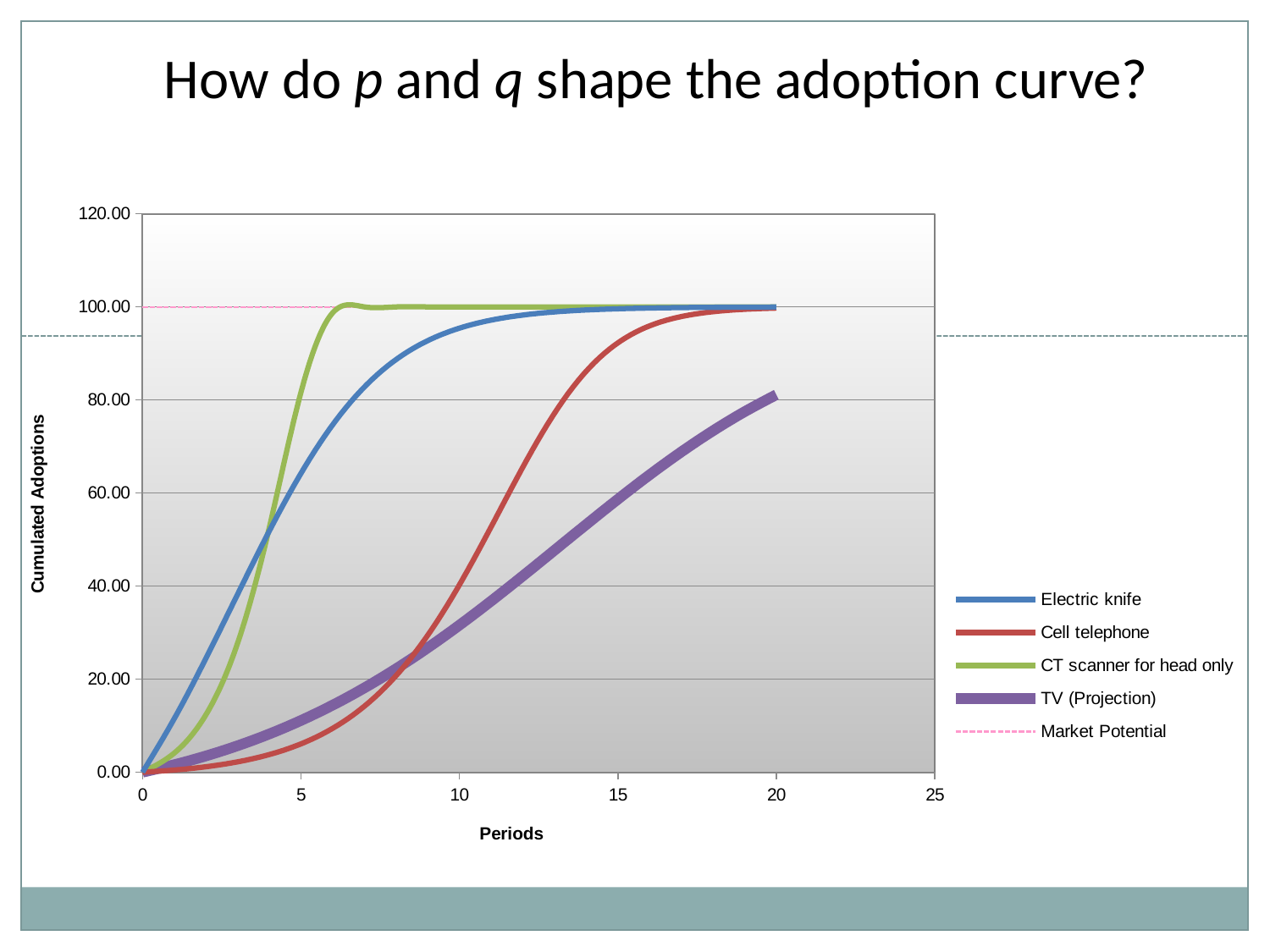
Is the value for Cell telephone at period 5 greater or less than 20.00? less How many series does the legend list? 5 Is the value for TV (Projection) at period 20 greater or less than 100.00? less What is the title of the chart's y axis? Cumulated Adoptions Do the Cell telephone values rise or fall as the periods increase? rise Is the value for Electric knife at period 10 greater or less than 80.00? greater At period 5, which is larger: Electric knife or Cell telephone? Electric knife At what level is the Market Potential line drawn? 100.00 What is the title of the chart's x axis? Periods At period 20, which is larger: Electric knife or TV (Projection)? Electric knife What kind of chart is shown on the slide? line chart Which series has the lowest cumulated adoptions at period 20? TV (Projection)